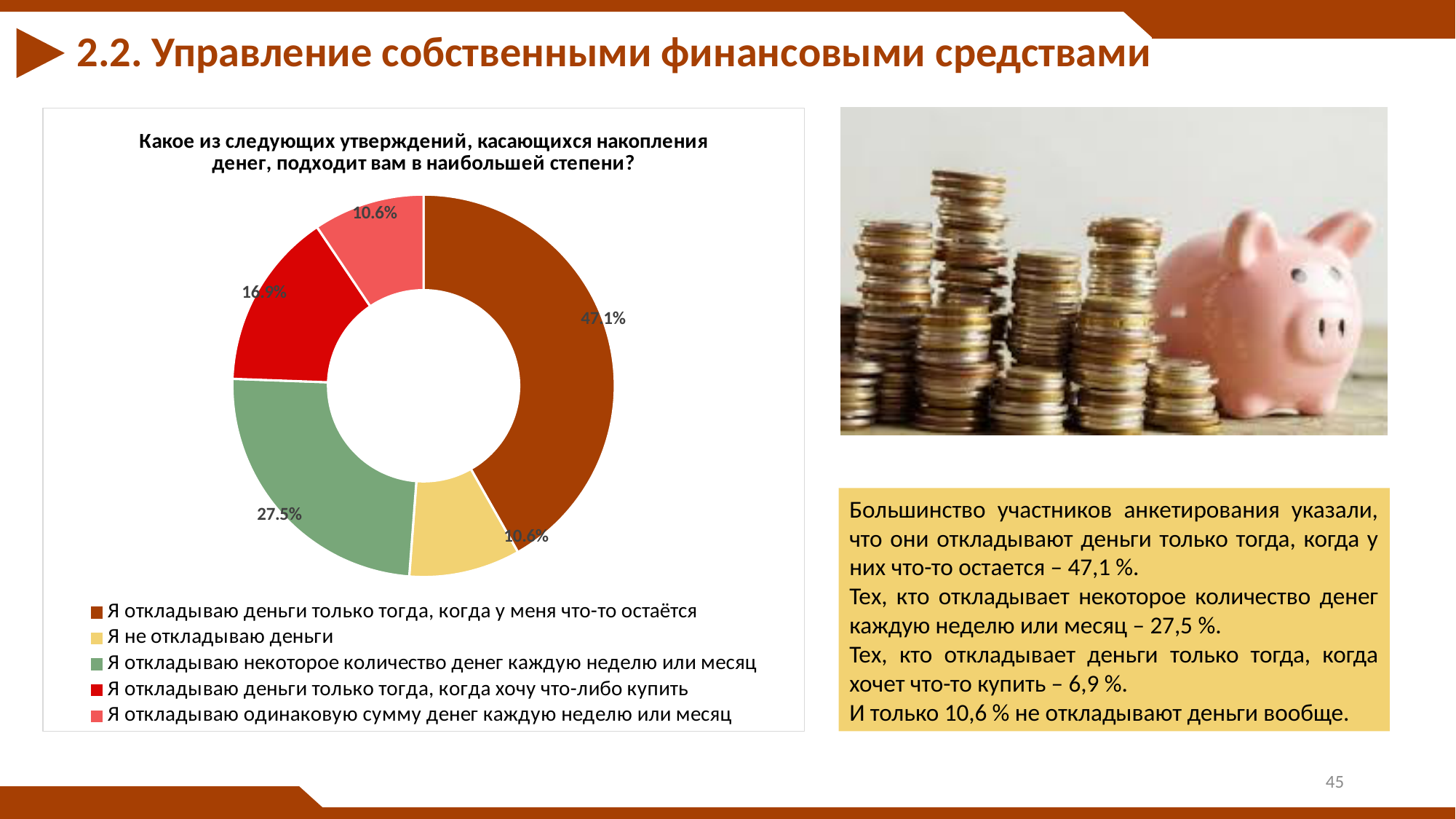
What share of respondents chose "Я откладываю одинаковую сумму денег каждую неделю или месяц"? 10.6% What share of respondents chose "Я не откладываю деньги"? 10.6% What colour is the slice for "Я не откладываю деньги"? Yellow Which slice is larger: "Я откладываю деньги только тогда, когда хочу что-либо купить" or "Я откладываю одинаковую сумму денег каждую неделю или месяц"? Я откладываю деньги только тогда, когда хочу что-либо купить Which answer option has the largest share of the pie? Я откладываю деньги только тогда, когда у меня что-то остаётся What share of respondents chose "Я откладываю некоторое количество денег каждую неделю или месяц"? 27.5% What share of respondents chose "Я откладываю деньги только тогда, когда у меня что-то остаётся"? 47.1% Which is larger: the share for "Я откладываю некоторое количество денег каждую неделю или месяц" or for "Я откладываю деньги только тогда, когда у меня что-то остаётся"? Я откладываю деньги только тогда, когда у меня что-то остаётся By how many percentage points does the share for "Я откладываю деньги только тогда, когда у меня что-то остаётся" exceed the share for "Я откладываю некоторое количество денег каждую неделю или месяц"? 19.6 percentage points How many answer options are shown in the chart legend? 5 What is the title of the chart? Какое из следующих утверждений, касающихся накопления денег, подходит вам в наибольшей степени? What type of chart is shown on the slide? Pie (doughnut) chart